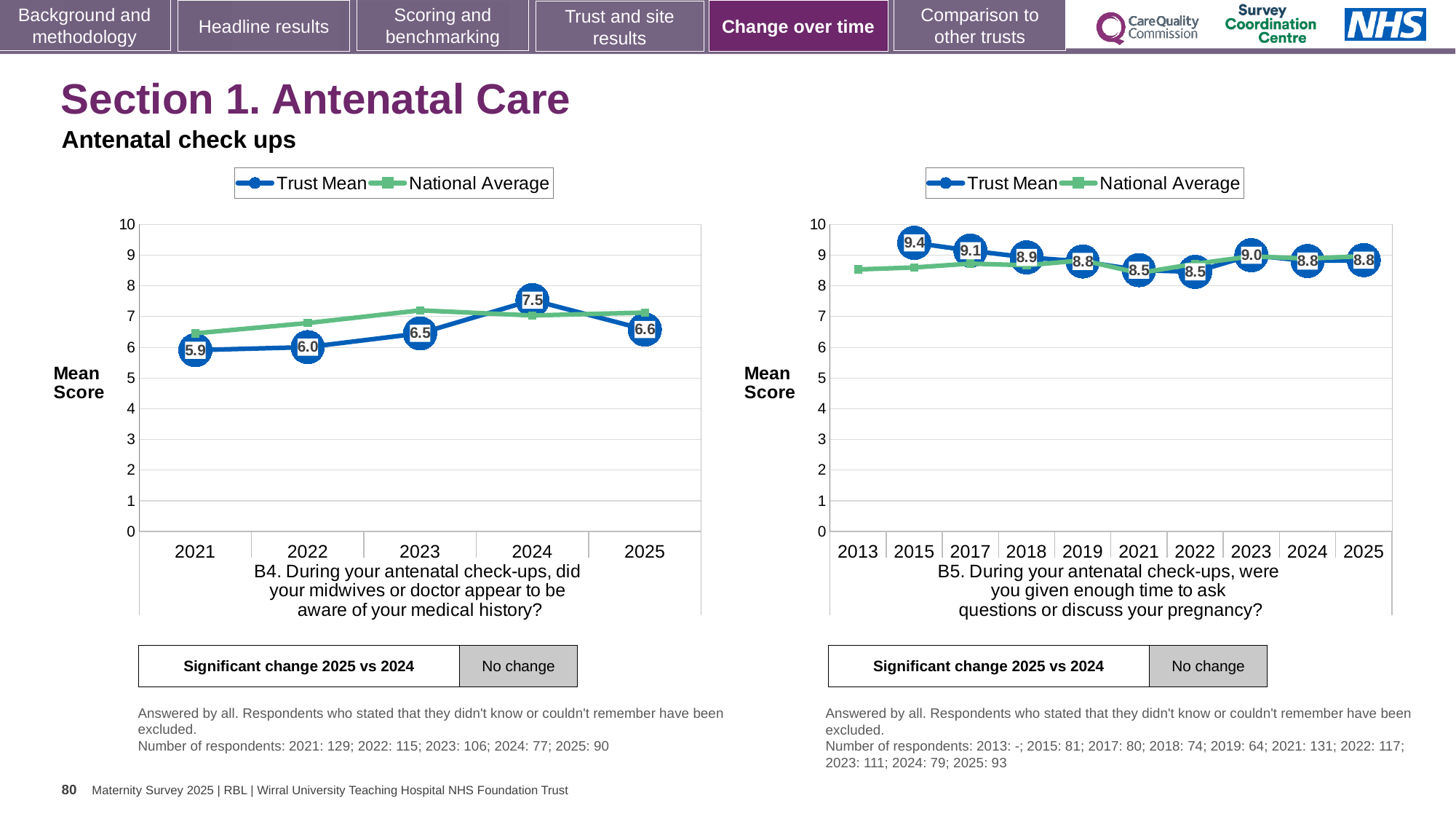
What type of chart is the left chart (B4)? Line chart In the right chart (B5), what is the Trust Mean score for 2015? 9.4 In the left chart (B4), what is the Trust Mean score for 2024? 7.5 In the right chart (B5), which is larger, the Trust Mean for 2023 or the Trust Mean for 2022? 2023 In the right chart (B5), which year has the highest Trust Mean score? 2015 In the right chart (B5), how many years are shown on the x axis? 10 In the left chart (B4), which year has the lowest Trust Mean score? 2021 In the right chart (B5), what is the Trust Mean score for 2025? 8.8 In the left chart (B4), what is the Trust Mean score for 2021? 5.9 In the left chart (B4), which year has the highest Trust Mean score? 2024 In the left chart (B4), what is the difference between the Trust Mean scores for 2024 and 2025? 0.9 In the left chart (B4), is the National Average for 2021 greater or less than 7? less